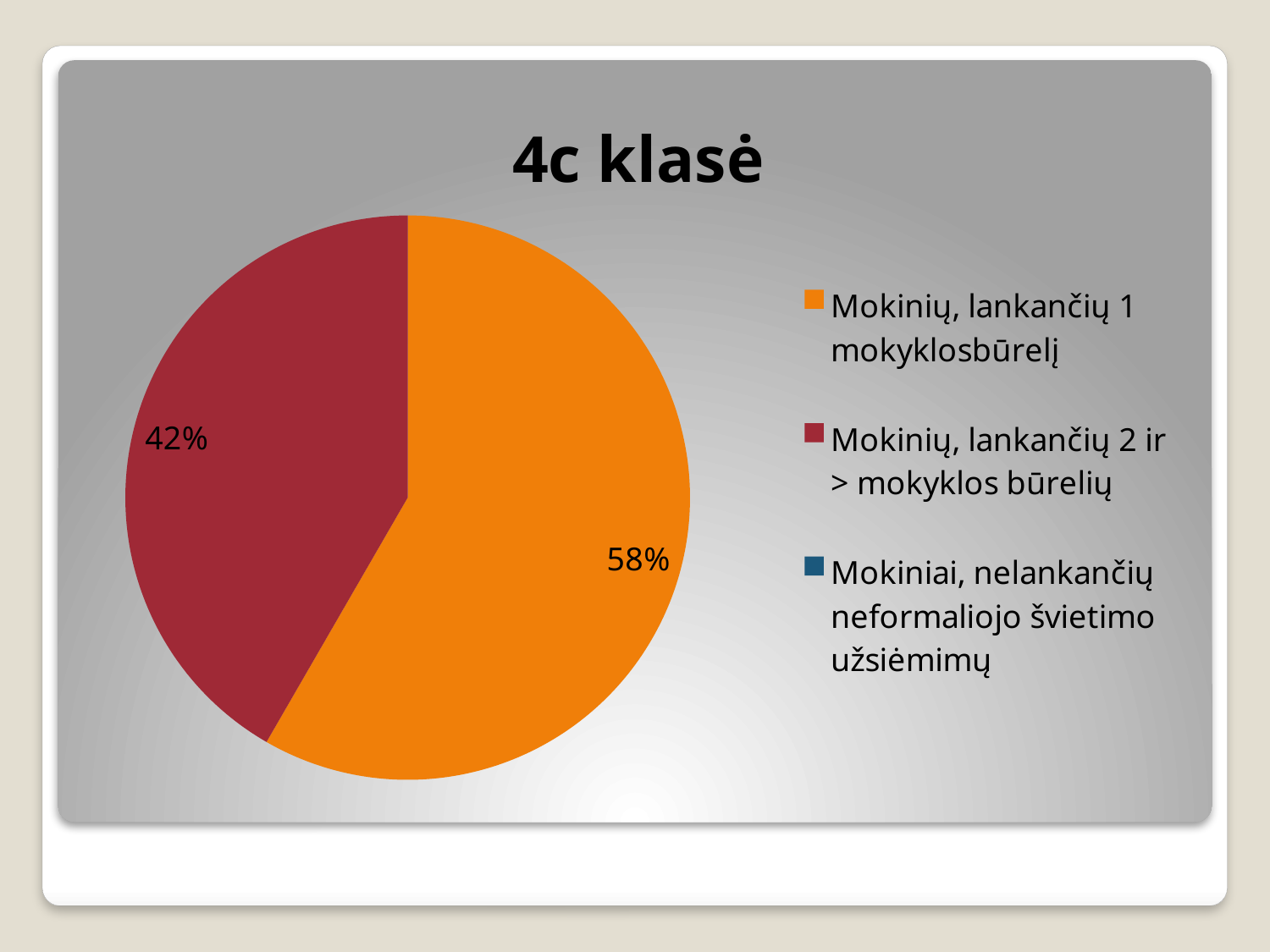
Is the share for "Mokinių, lankančių 1 mokyklosbūrelį" greater or less than 50%? greater How many slices are visible in the pie? 2 Which of the two visible slices is smaller? Mokinių, lankančių 2 ir > mokyklos būrelių What share of the pie is labelled for "Mokinių, lankančių 2 ir > mokyklos būrelių"? 42% What kind of chart is shown on the slide? pie chart What colour is the slice for "Mokinių, lankančių 1 mokyklosbūrelį"? orange How many entries does the legend list? 3 What is the difference in percentage points between the 58% slice and the 42% slice? 16 What is the title of the chart? 4c klasė What share of the pie is labelled for "Mokinių, lankančių 1 mokyklosbūrelį"? 58% Which is larger: the share for "Mokinių, lankančių 1 mokyklosbūrelį" or the share for "Mokinių, lankančių 2 ir > mokyklos būrelių"? Mokinių, lankančių 1 mokyklosbūrelį Which category has the largest slice of the pie? Mokinių, lankančių 1 mokyklosbūrelį